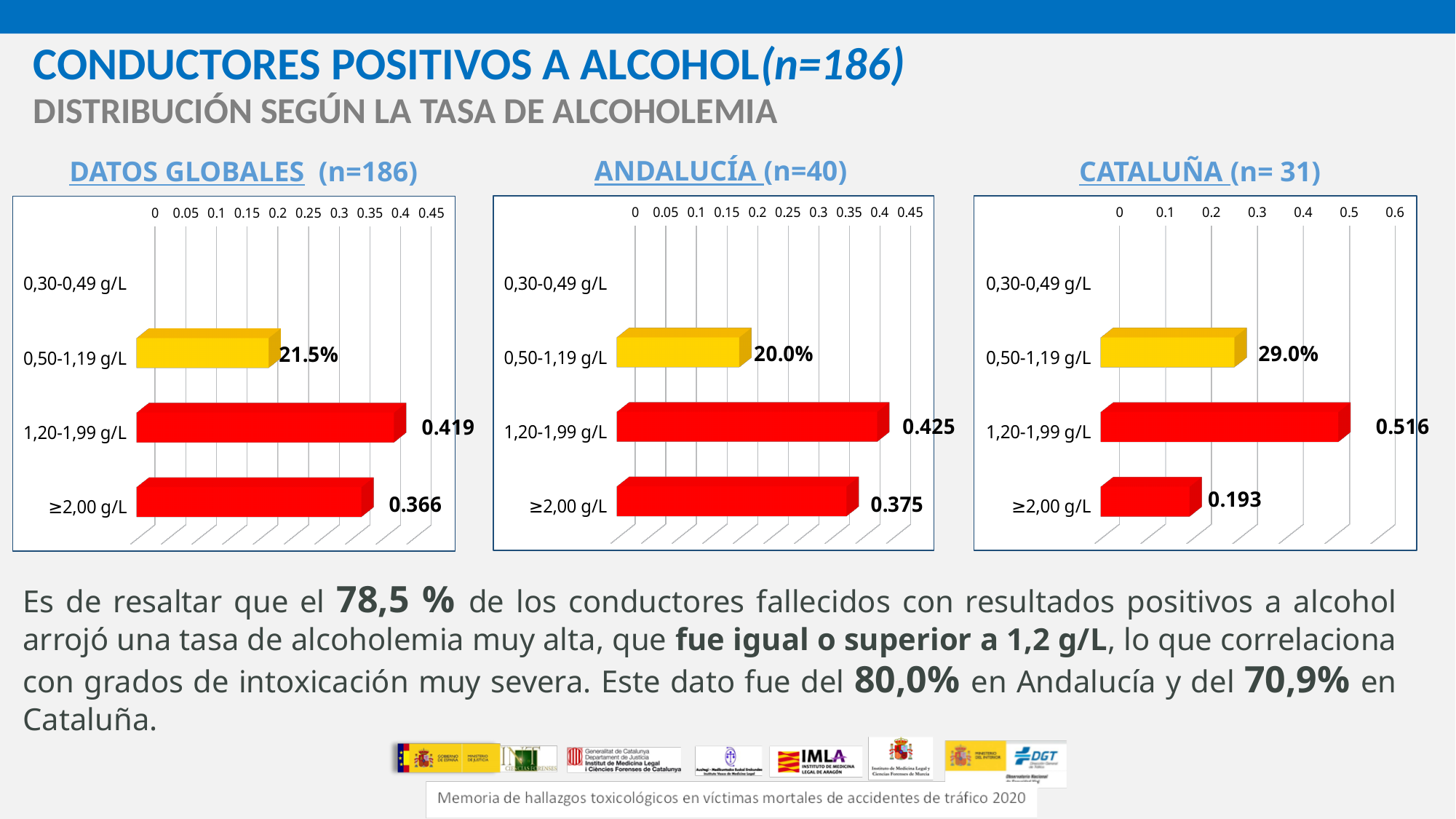
In the DATOS GLOBALES chart, what is the value for the 1,20-1,99 g/L category? 0.419 In the ANDALUCÍA chart, what is the value for the ≥2,00 g/L category? 0.375 In the DATOS GLOBALES chart, what is the difference between the values for 1,20-1,99 g/L and ≥2,00 g/L? 0.053 In the CATALUÑA chart, is the value for 1,20-1,99 g/L greater or less than 0.5? greater What kind of chart is the ANDALUCÍA chart? bar chart How many categories are listed on the vertical axis of the DATOS GLOBALES chart? 4 In the ANDALUCÍA chart, which category has the highest value? 1,20-1,99 g/L In the DATOS GLOBALES chart, what is the value for the 0,50-1,19 g/L category? 21.5% In the CATALUÑA chart, which category has the highest value? 1,20-1,99 g/L In the CATALUÑA chart, what is the difference between the values for 1,20-1,99 g/L and ≥2,00 g/L? 0.323 In the CATALUÑA chart, what is the value for the 0,50-1,19 g/L category? 29.0% In the ANDALUCÍA chart, which is larger: the value for 1,20-1,99 g/L or the value for ≥2,00 g/L? 1,20-1,99 g/L